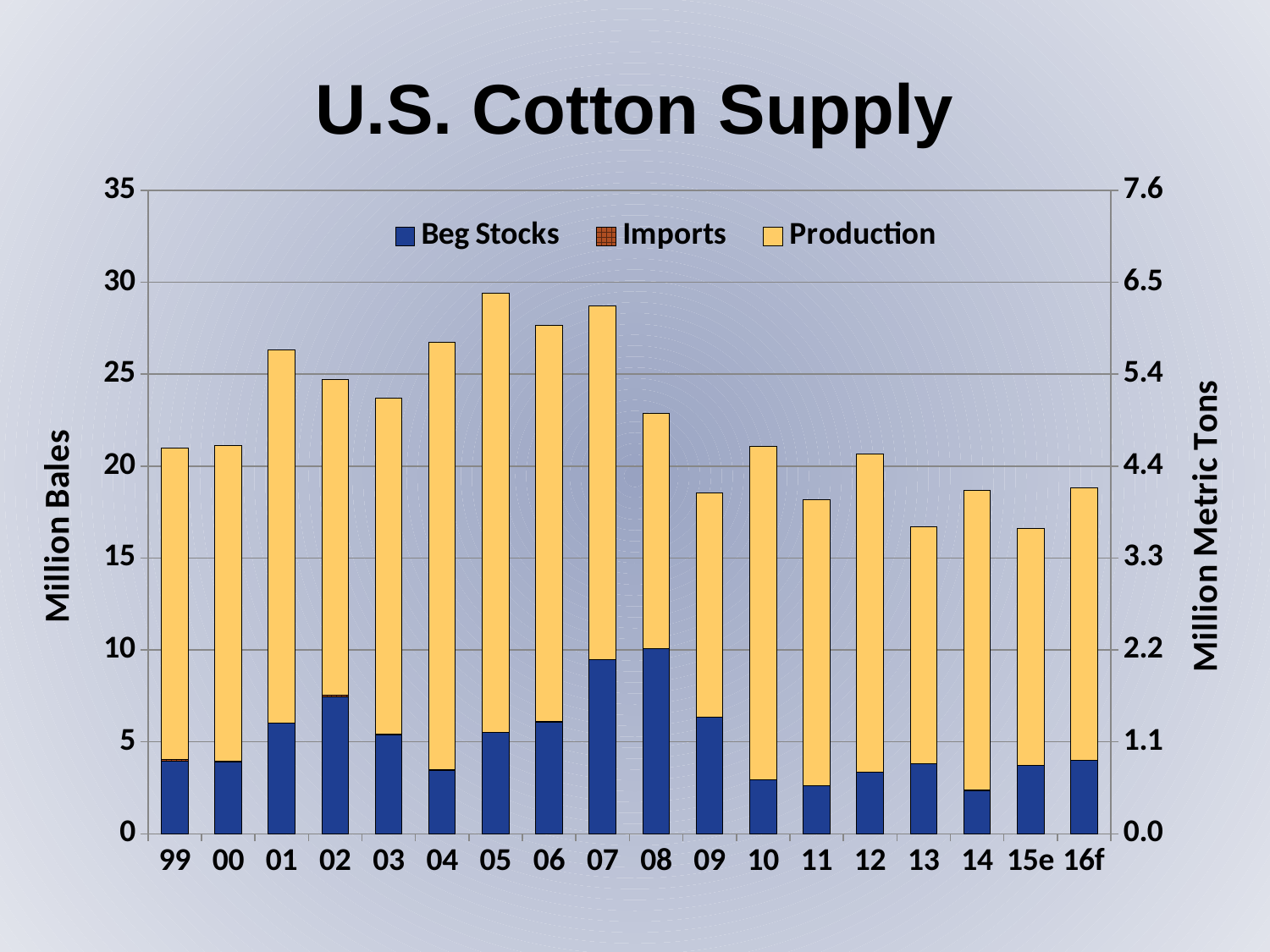
What is the title of the right vertical axis? Million Metric Tons Is the Beg Stocks value for 08 greater or less than 5 million bales? greater What is the title of the left vertical axis? Million Bales Which year has the largest Beg Stocks value? 08 Which year has the highest total U.S. cotton supply? 05 How many years (categories) are shown on the x axis? 18 How many series does the legend list? 3 What type of chart is shown on the slide? Stacked bar chart Is the total supply for 13 greater or less than 20 million bales? less Which year has the larger Beg Stocks value, 02 or 03? 02 Is the total supply for 05 greater or less than 25 million bales? greater Which year has the larger total supply, 01 or 02? 01